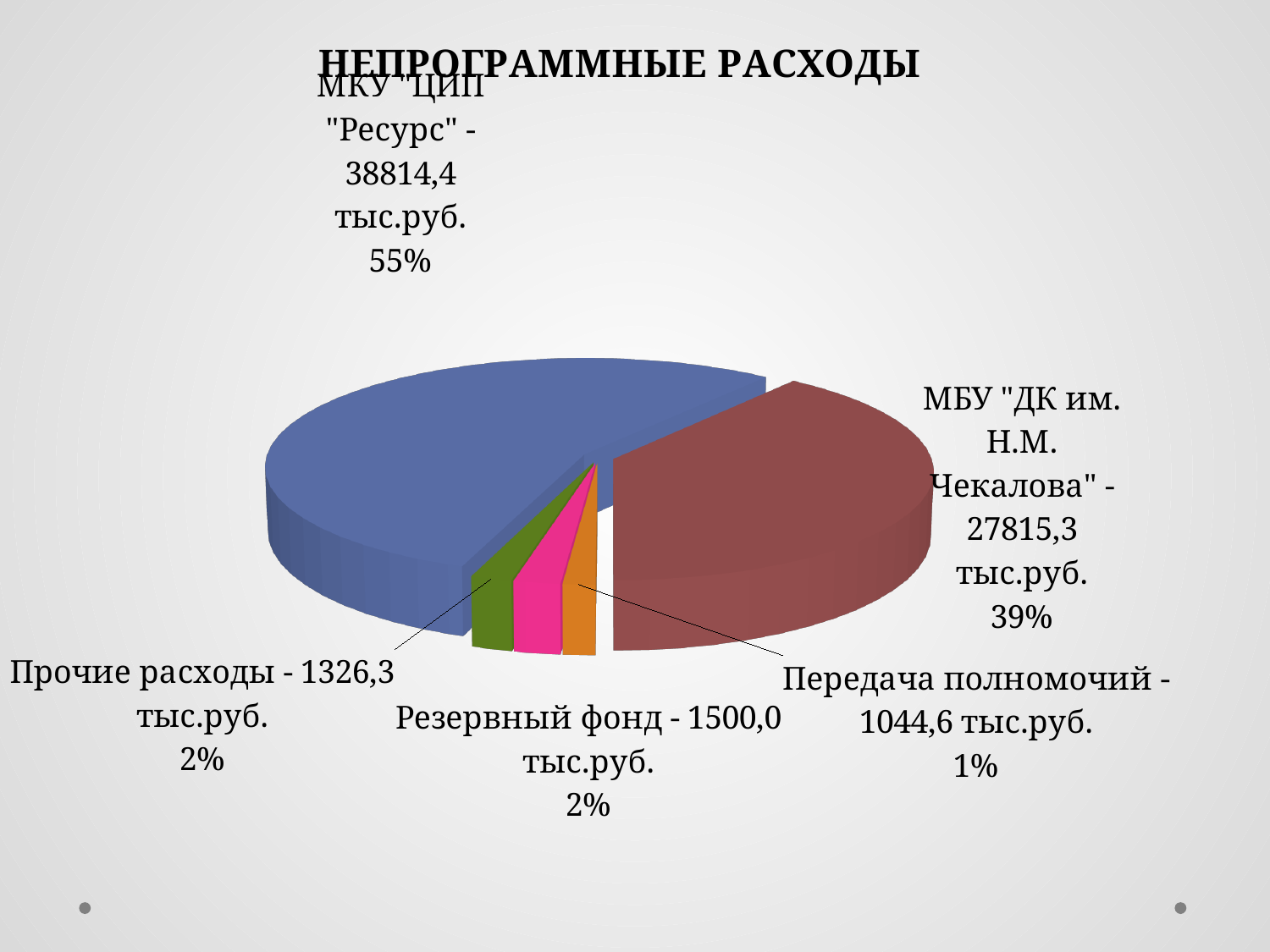
What is the title of the chart? НЕПРОГРАММНЫЕ РАСХОДЫ How many slices does the pie chart have? 5 What share of the pie does Резервный фонд represent? 2% What is the difference between the values for МКУ "ЦИП "Ресурс" and МБУ "ДК им. Н.М. Чекалова"? 10999,1 тыс.руб. Which category has the smallest share of the pie? Передача полномочий Which category has the largest share of the pie? МКУ "ЦИП "Ресурс" Which is larger, the value for Резервный фонд or the value for Прочие расходы? Резервный фонд What type of chart is shown on the slide? pie chart What share of the pie does МБУ "ДК им. Н.М. Чекалова" represent? 39% What is the value for Передача полномочий? 1044,6 тыс.руб. What is the value for МКУ "ЦИП "Ресурс"? 38814,4 тыс.руб. What is the value for МБУ "ДК им. Н.М. Чекалова"? 27815,3 тыс.руб.